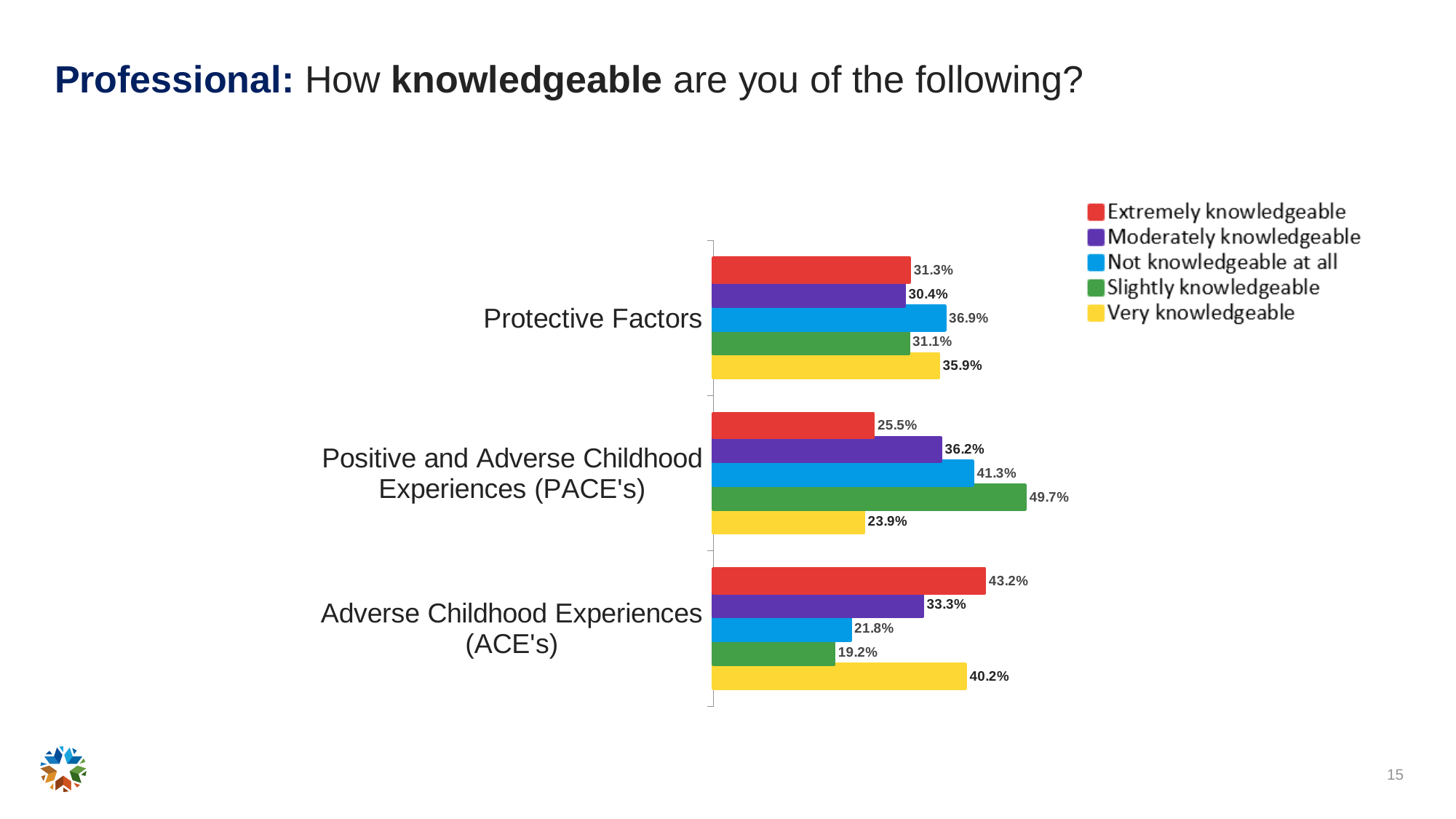
Which category has the highest Slightly knowledgeable value? Positive and Adverse Childhood Experiences (PACE's) What percentage of professionals are Extremely knowledgeable about Adverse Childhood Experiences (ACE's)? 43.2% What percentage of professionals are Slightly knowledgeable about Positive and Adverse Childhood Experiences (PACE's)? 49.7% Which category has the lowest Very knowledgeable value? Positive and Adverse Childhood Experiences (PACE's) What percentage of professionals are Not knowledgeable at all about Adverse Childhood Experiences (ACE's)? 21.8% How many series does the legend list? 5 What is the difference between the Extremely knowledgeable values for Adverse Childhood Experiences (ACE's) and Positive and Adverse Childhood Experiences (PACE's)? 17.7% Which colour represents the Very knowledgeable series in the legend? Yellow How many categories are shown on the chart? 3 What percentage of professionals are Very knowledgeable about Protective Factors? 35.9% Which is larger for Protective Factors: the Not knowledgeable at all value or the Moderately knowledgeable value? Not knowledgeable at all What kind of chart is shown on the slide? Bar chart